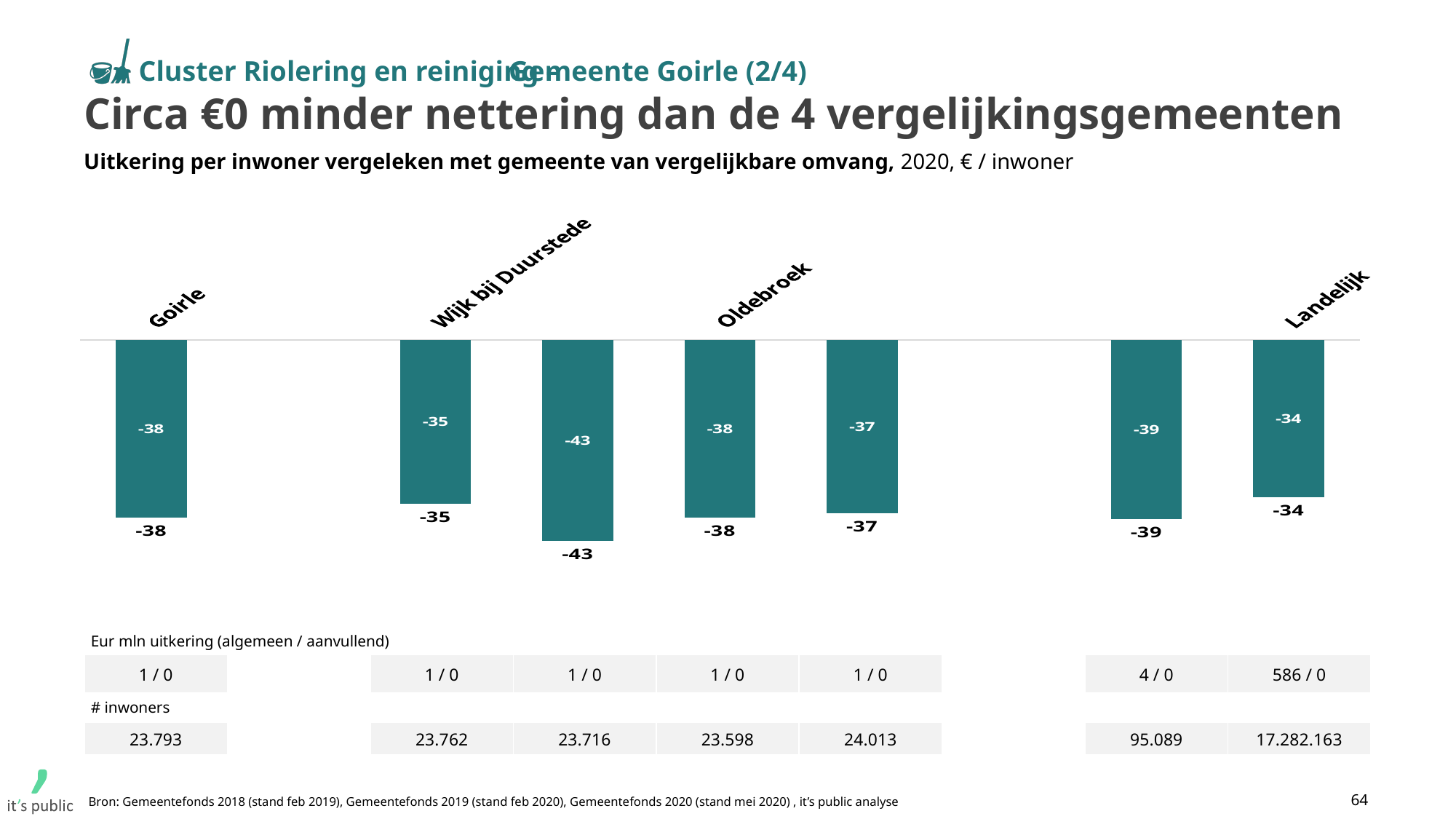
What is the value for Wijk bij Duurstede? -35 What is the difference between the value for Landelijk and the value for Goirle? 4 How many bars are plotted on the chart? 7 What is the value for Goirle? -38 What is the lowest value shown on the chart? -43 What kind of chart is shown on the slide? Bar chart Which is larger, the value for Goirle or the value for Landelijk? Landelijk What unit is stated in the chart subtitle? € / inwoner What is the value for Landelijk? -34 Which labelled category has the highest value? Landelijk What is the difference between the value for Wijk bij Duurstede and the value for Goirle? 3 What is the value for Oldebroek? -38